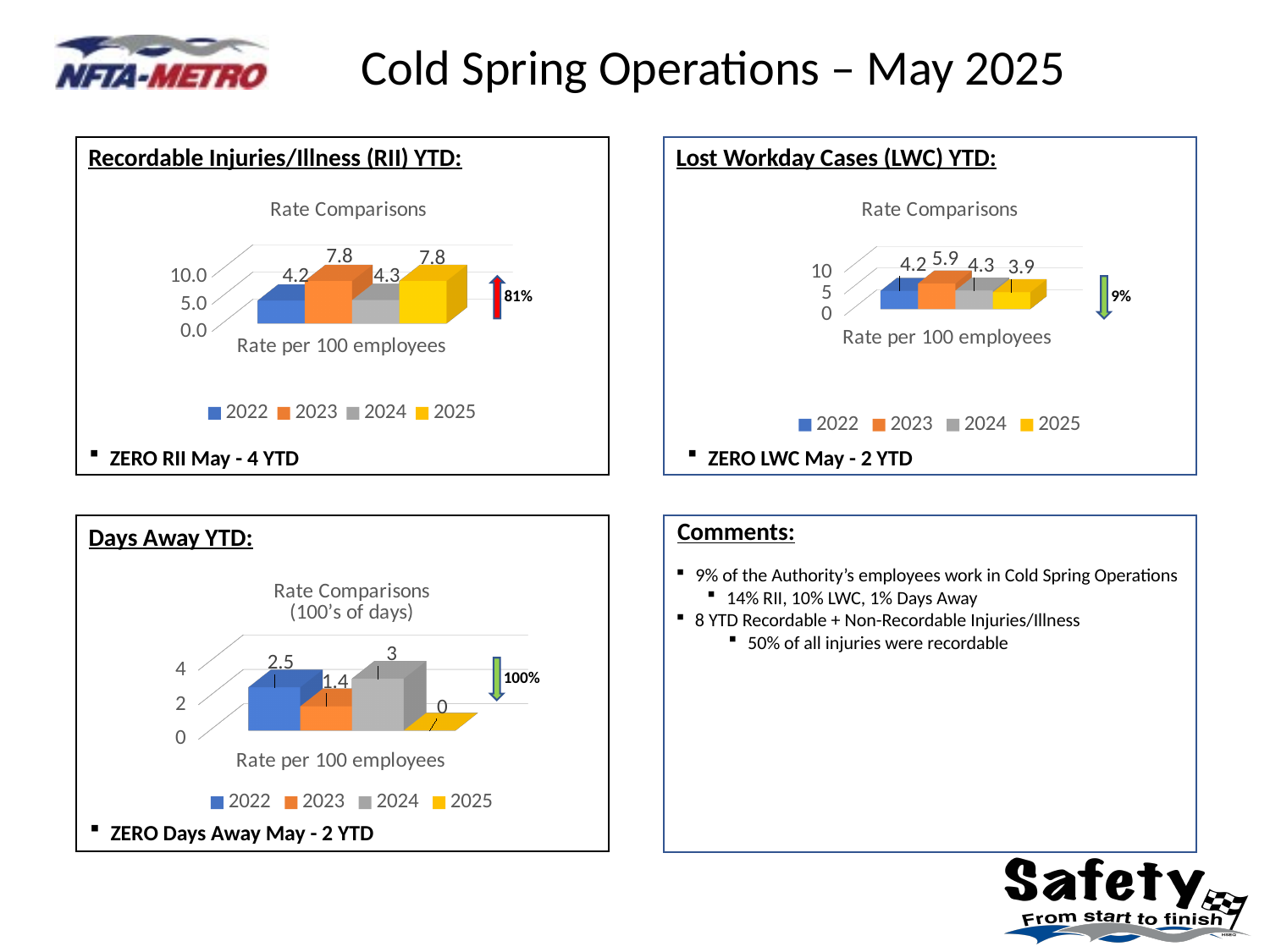
In the Recordable Injuries/Illness (RII) YTD chart, what is the difference between the 2025 and 2024 rates? 3.5 What percentage change is shown next to the arrow in the Days Away YTD chart? 100% In the Lost Workday Cases (LWC) YTD chart, what is the rate per 100 employees for 2025? 3.9 In the Lost Workday Cases (LWC) YTD chart, which year has the highest rate per 100 employees? 2023 In the Days Away YTD chart, is the value for 2022 larger or smaller than the value for 2023? larger How many series does the legend list in the Recordable Injuries/Illness (RII) YTD chart? 4 In the Days Away YTD chart, what is the value for 2025? 0 What kind of chart is the Lost Workday Cases (LWC) YTD chart? bar chart In the Days Away YTD chart, which year has the highest value? 2024 In the Recordable Injuries/Illness (RII) YTD chart, what is the rate per 100 employees for 2025? 7.8 In the Lost Workday Cases (LWC) YTD chart, which year has the lowest rate per 100 employees? 2025 In the Recordable Injuries/Illness (RII) YTD chart, what is the rate per 100 employees for 2022? 4.2